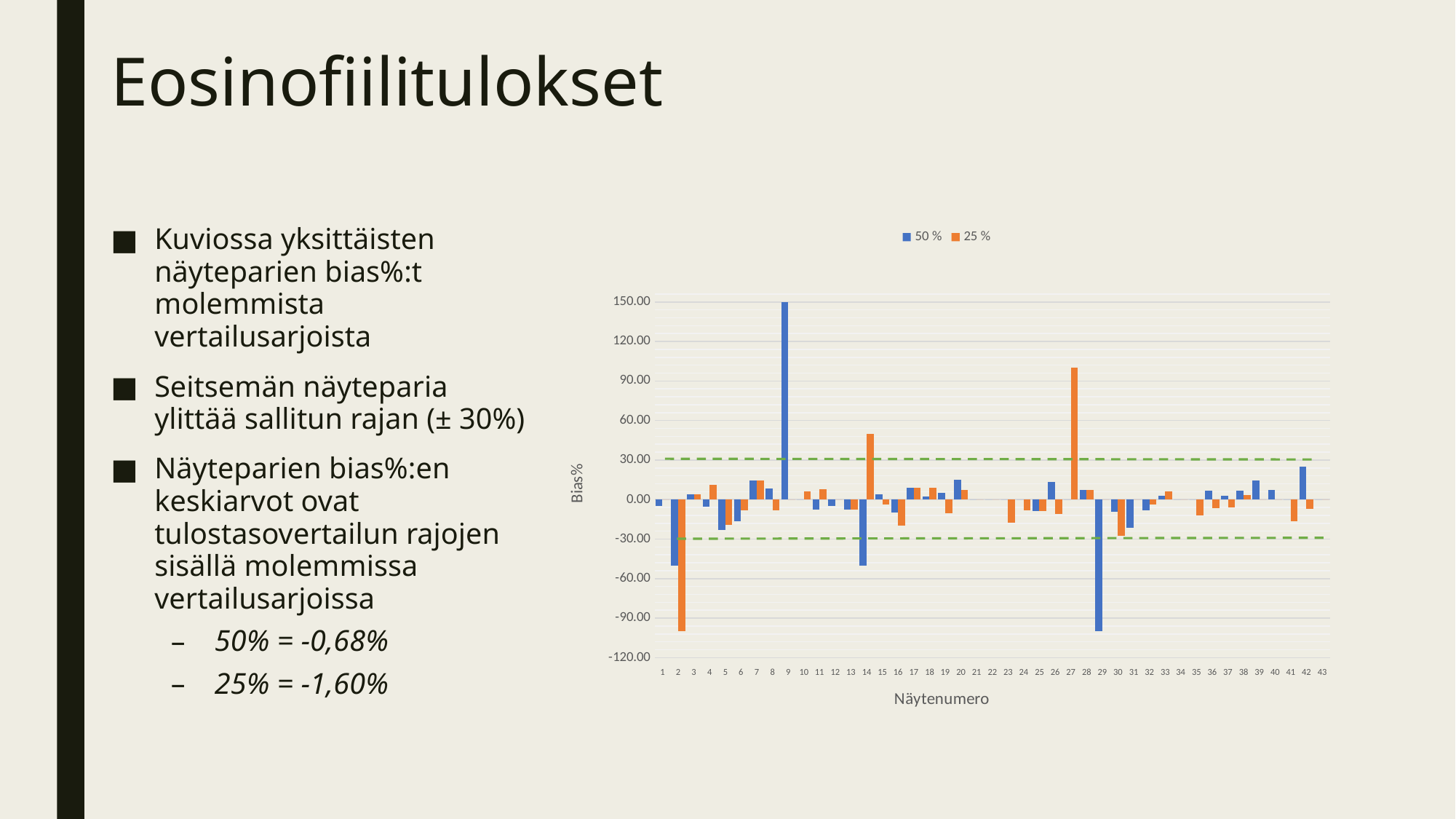
What kind of chart is shown on the slide? bar chart Is the 50 % value for sample 29 greater or less than -60.00? less What are the two series named in the chart legend? 50 % and 25 % How many sample numbers (Näytenumero) are shown along the x axis of the chart? 43 How many series does the chart legend list? 2 Is the 25 % value for sample 27 greater or less than 60.00? greater Is the 50 % value for sample 9 greater or less than 120.00? greater Which sample number has the lowest value for the 25 % series? 2 Which sample number has the lowest value for the 50 % series? 29 What is the title of the y axis of the chart? Bias% Which sample number has the highest value for the 25 % series? 27 Which sample number has the highest value for the 50 % series? 9